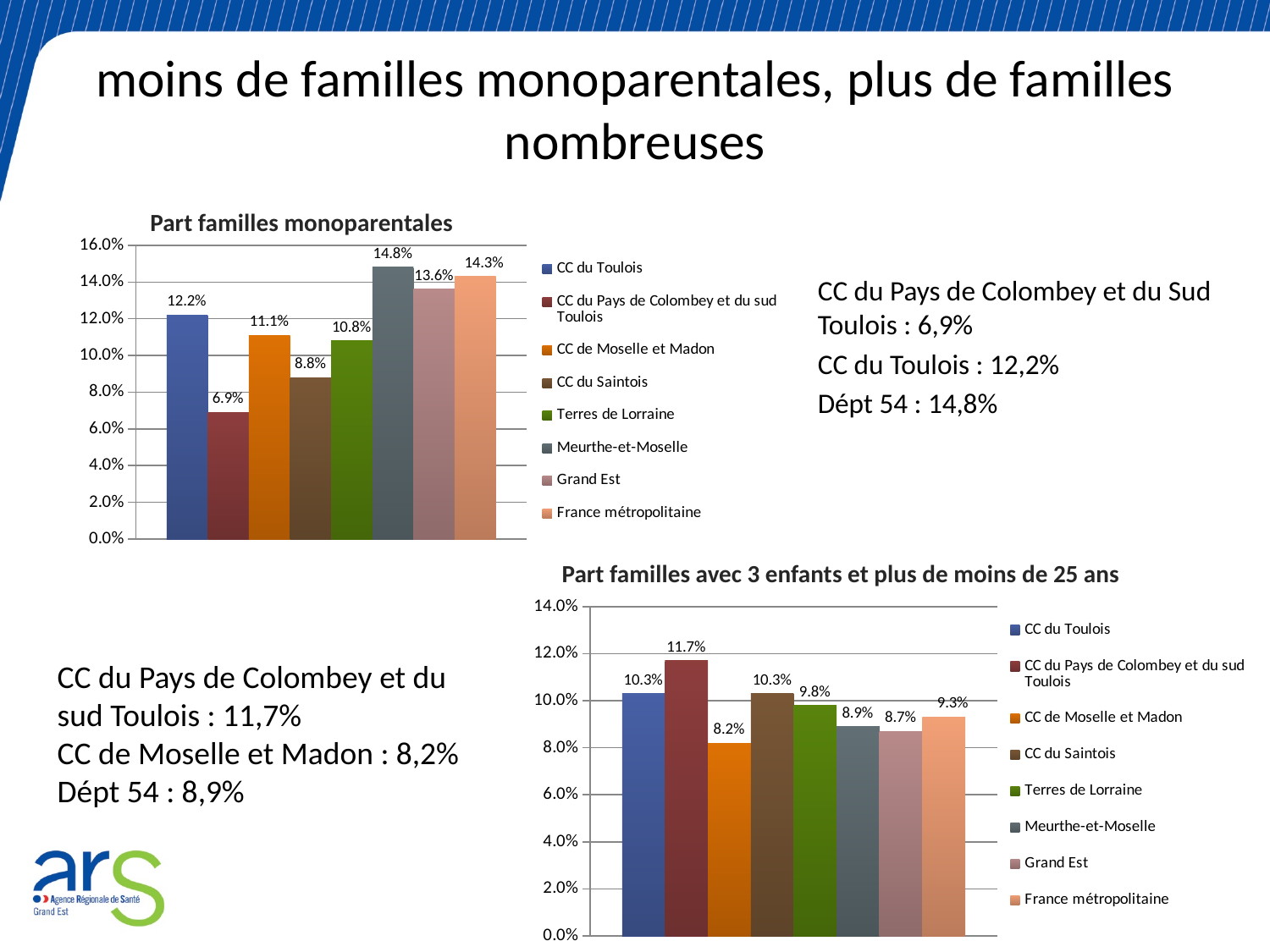
In the 'Part familles monoparentales' chart, which category has the lowest value? CC du Pays de Colombey et du sud Toulois In the 'Part familles avec 3 enfants et plus de moins de 25 ans' chart, which category has the lowest value? CC de Moselle et Madon In the 'Part familles monoparentales' chart, what is the value for CC du Toulois? 12.2% In the 'Part familles avec 3 enfants et plus de moins de 25 ans' chart, what is the value for CC de Moselle et Madon? 8.2% In the 'Part familles monoparentales' chart, what is the difference between Meurthe-et-Moselle and CC du Pays de Colombey et du sud Toulois? 7.9% In the 'Part familles monoparentales' chart, how many legend entries are listed? 8 In the 'Part familles avec 3 enfants et plus de moins de 25 ans' chart, which category has the highest value? CC du Pays de Colombey et du sud Toulois In the 'Part familles monoparentales' chart, which is larger: Grand Est or France métropolitaine? France métropolitaine In the 'Part familles monoparentales' chart, which category has the highest value? Meurthe-et-Moselle What kind of chart is the 'Part familles avec 3 enfants et plus de moins de 25 ans' chart? Bar chart In the 'Part familles avec 3 enfants et plus de moins de 25 ans' chart, what is the value for Grand Est? 8.7% In the 'Part familles avec 3 enfants et plus de moins de 25 ans' chart, what is the difference between CC du Pays de Colombey et du sud Toulois and Meurthe-et-Moselle? 2.8%